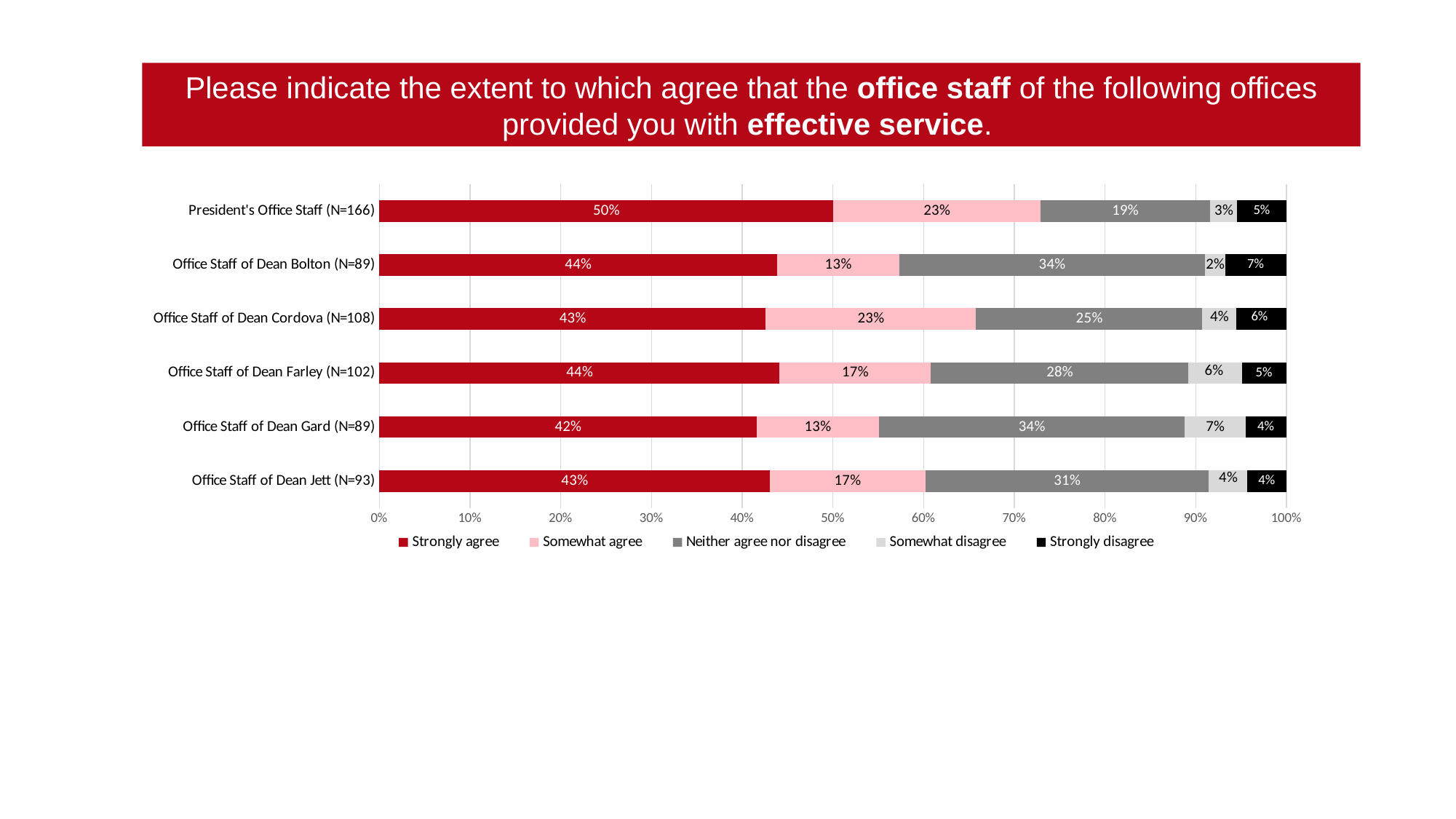
Which office has the highest 'Strongly disagree' percentage? Office Staff of Dean Bolton (N=89) What is the difference in 'Strongly agree' percentage between President's Office Staff (N=166) and Office Staff of Dean Gard (N=89)? 8 percentage points How many offices are shown on the chart? 6 Which office has the lowest 'Strongly agree' percentage? Office Staff of Dean Gard (N=89) What colour represents 'Strongly agree' in the chart? Dark red How many response categories does the legend list? 5 What is the 'Somewhat disagree' value for Office Staff of Dean Gard (N=89)? 7% What is the 'Neither agree nor disagree' value for Office Staff of Dean Bolton (N=89)? 34% What percentage of respondents strongly agree that the President's Office Staff (N=166) provided effective service? 50% Which has a larger 'Somewhat agree' percentage: Office Staff of Dean Cordova (N=108) or Office Staff of Dean Farley (N=102)? Office Staff of Dean Cordova (N=108) What kind of chart is shown on the slide? Stacked bar chart Which office has the highest 'Strongly agree' percentage? President's Office Staff (N=166)